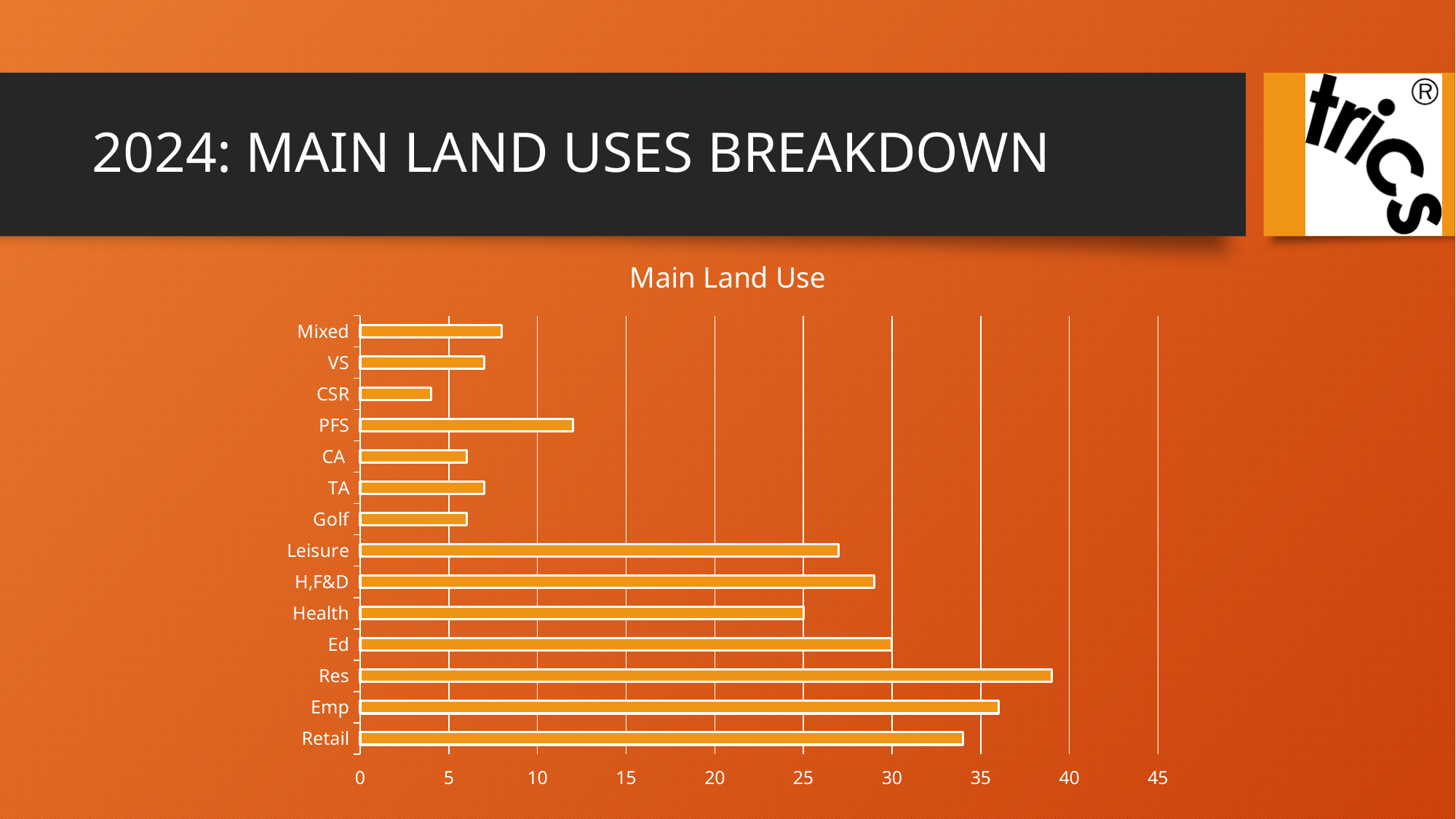
What type of chart is shown on the slide? Bar chart Which has the larger value, Res or Emp? Res What is the title of the chart? Main Land Use How many land use categories are plotted in the chart? 14 Is the value for CSR greater or less than 5? less Which land use category has the highest value? Res What is the value for Ed? 30 Which has the larger value, Leisure or H,F&D? H,F&D Which land use category has the lowest value? CSR Is the value for PFS greater or less than 10? greater Is the value for Res greater or less than 35? greater What is the value for Health? 25